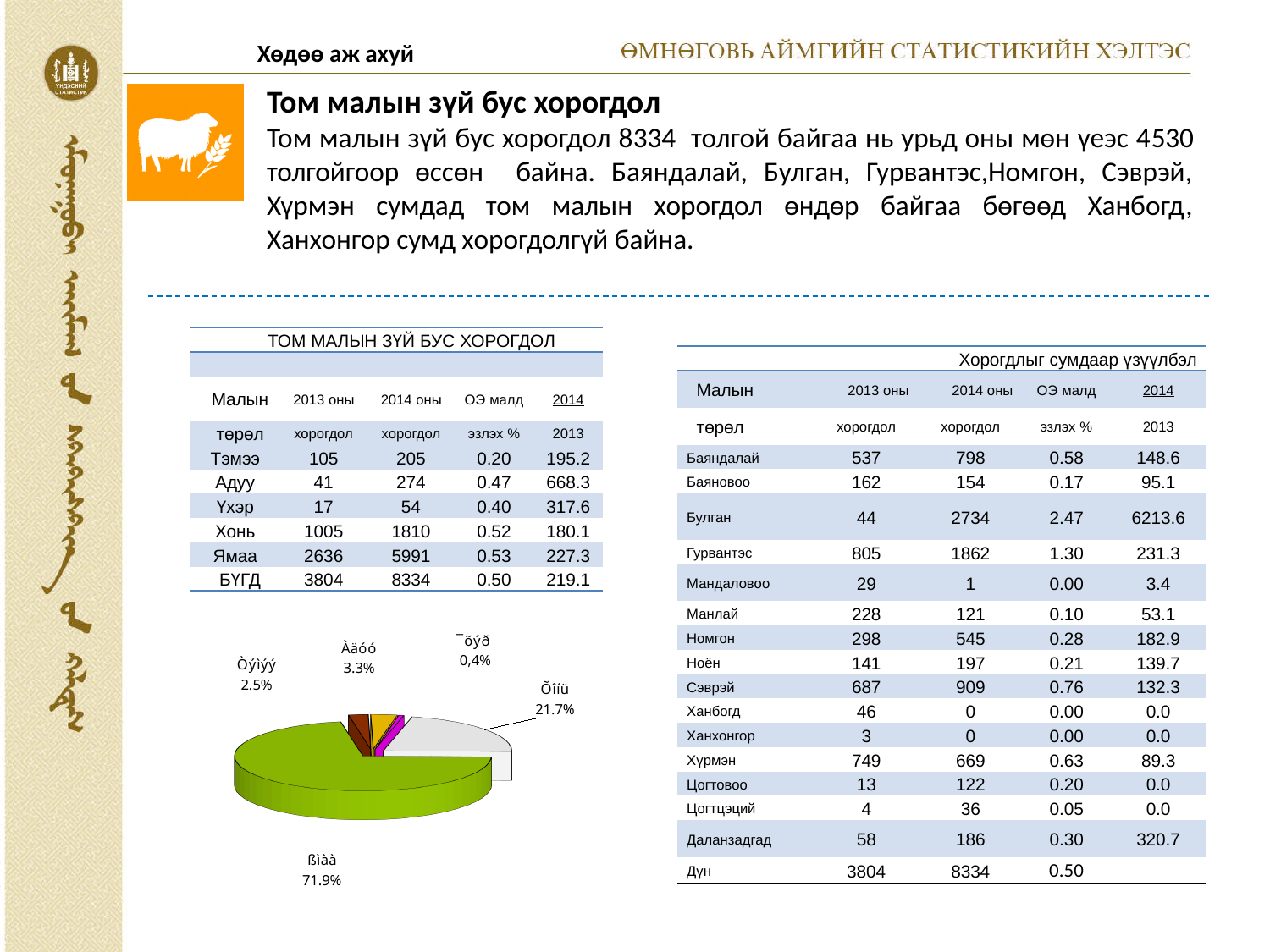
What share does the largest slice of the pie chart have? 71.9% What kind of chart is shown at the bottom left of the slide? pie chart By how many percentage points does the largest slice of the pie chart exceed the second-largest slice? 50.2 Is the largest slice of the pie chart greater or less than 50%? greater What colour is the largest slice of the pie chart? green What share does the smallest slice of the pie chart have? 0,4% What share does the second-largest slice of the pie chart have? 21.7% How many slices does the pie chart have? 5 Which is larger in the pie chart: the slice labelled 3.3% or the slice labelled 2.5%? the slice labelled 3.3%